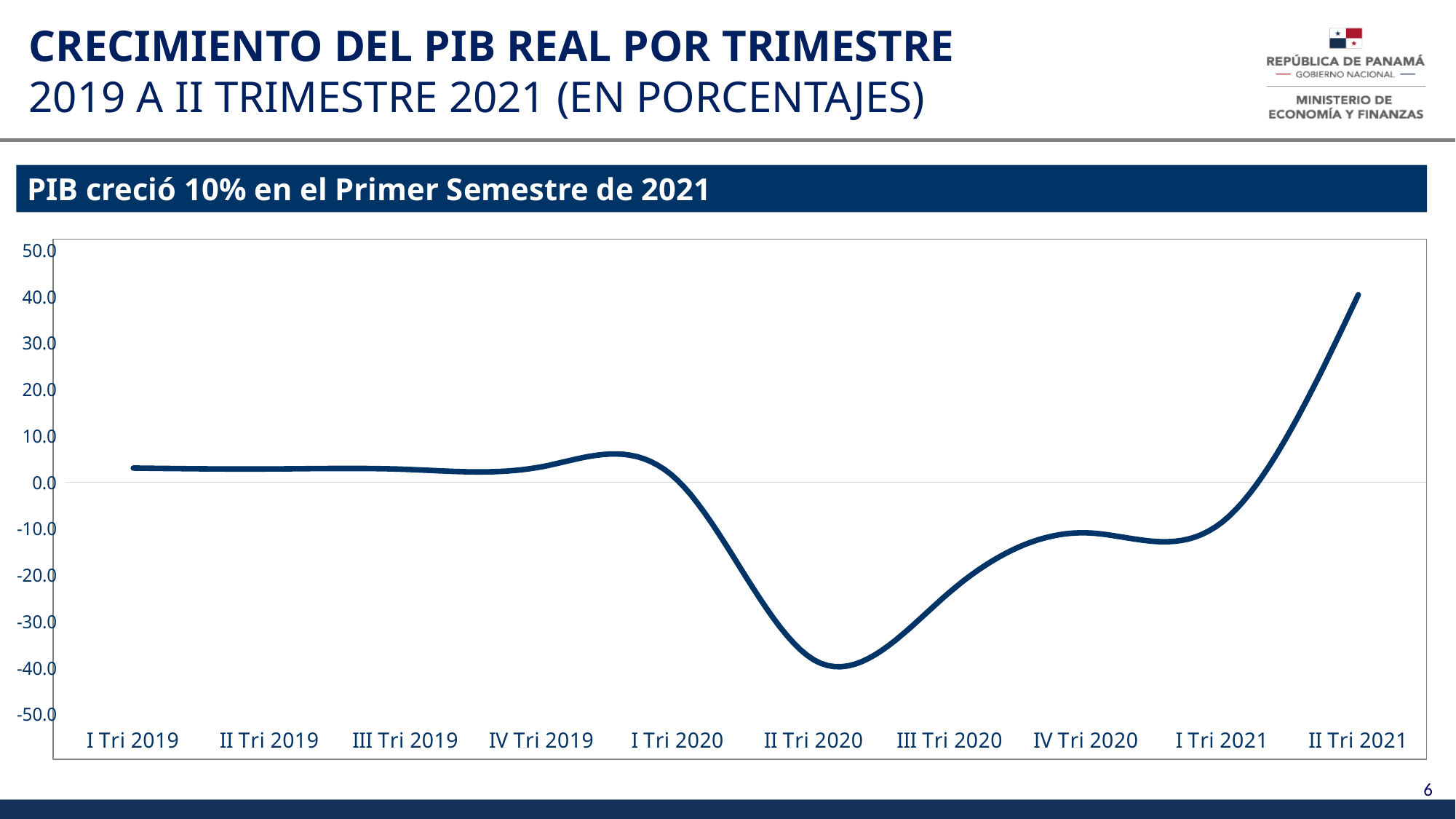
What kind of chart is shown on the slide? line chart Is the value for II Tri 2020 greater or less than -30.0? less How many quarters are plotted on the x axis? 10 Is the value for II Tri 2021 greater or less than 30.0? greater Is the value for III Tri 2020 greater or less than -10.0? less Does the line rise or fall from II Tri 2020 to II Tri 2021? rise Which quarter has the highest real GDP growth value? II Tri 2021 Which quarter has the lowest real GDP growth value? II Tri 2020 Which is larger, the value for II Tri 2020 or the value for IV Tri 2020? IV Tri 2020 What does the banner above the chart say? PIB creció 10% en el Primer Semestre de 2021